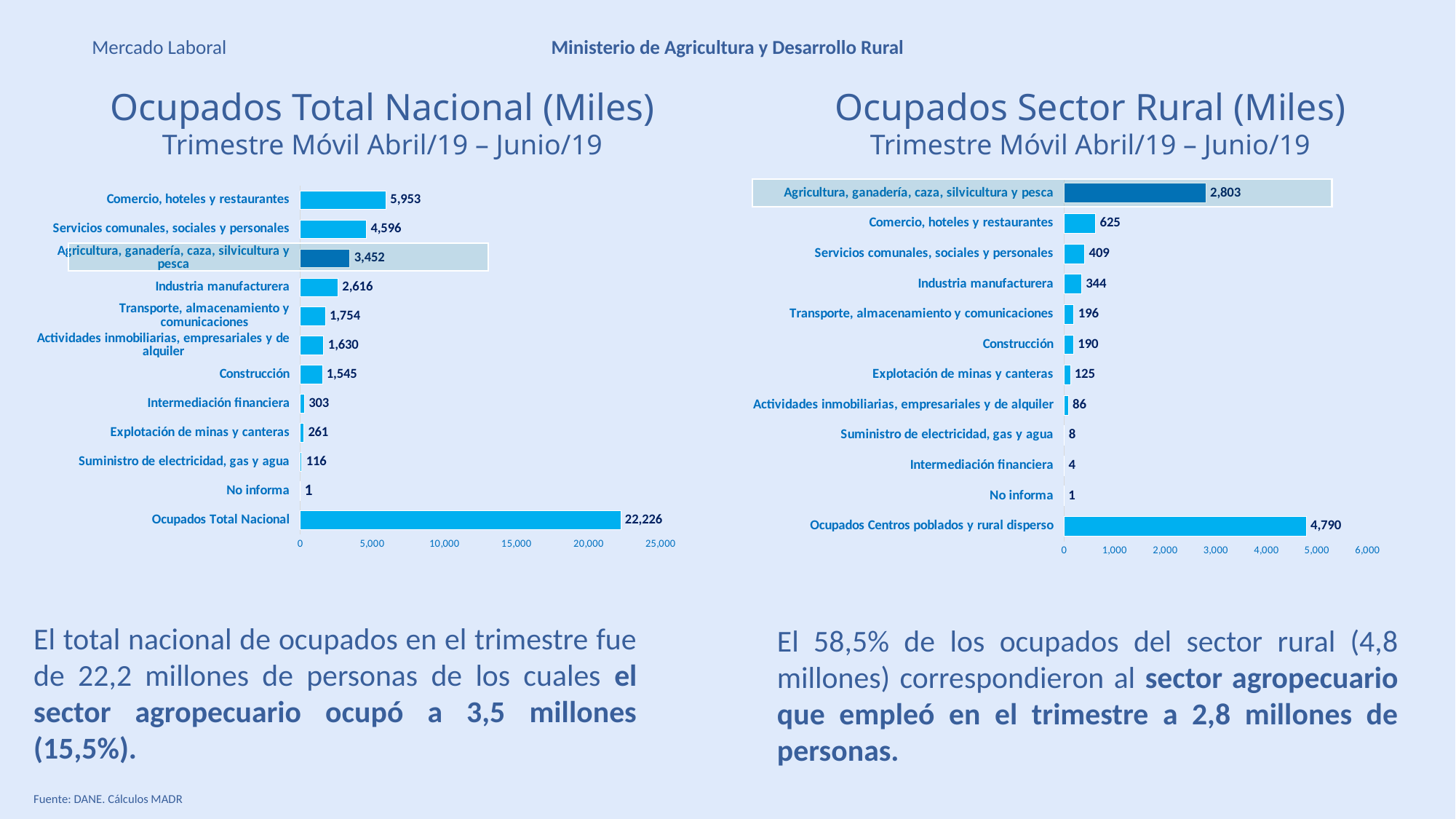
In the 'Ocupados Total Nacional (Miles)' chart, what is the value for Agricultura, ganadería, caza, silvicultura y pesca? 3,452 In the 'Ocupados Total Nacional (Miles)' chart, is the value for Ocupados Total Nacional greater or less than 20,000? greater In the 'Ocupados Total Nacional (Miles)' chart, what is the difference between Industria manufacturera and Construcción? 1,071 In the 'Ocupados Total Nacional (Miles)' chart, what is the value for Comercio, hoteles y restaurantes? 5,953 In the 'Ocupados Sector Rural (Miles)' chart, what is the value for Ocupados Centros poblados y rural disperso? 4,790 In the 'Ocupados Sector Rural (Miles)' chart, which sector (excluding the total bar) has the highest value? Agricultura, ganadería, caza, silvicultura y pesca How many bars are shown in the 'Ocupados Sector Rural (Miles)' chart? 12 What type of chart is the 'Ocupados Total Nacional (Miles)' chart? Bar chart In the 'Ocupados Sector Rural (Miles)' chart, what is the difference between Comercio, hoteles y restaurantes and Servicios comunales, sociales y personales? 216 In the 'Ocupados Sector Rural (Miles)' chart, what is the value for Agricultura, ganadería, caza, silvicultura y pesca? 2,803 In the 'Ocupados Sector Rural (Miles)' chart, which is larger: Transporte, almacenamiento y comunicaciones or Construcción? Transporte, almacenamiento y comunicaciones In the 'Ocupados Total Nacional (Miles)' chart, which sector (excluding the total bar) has the lowest value? No informa